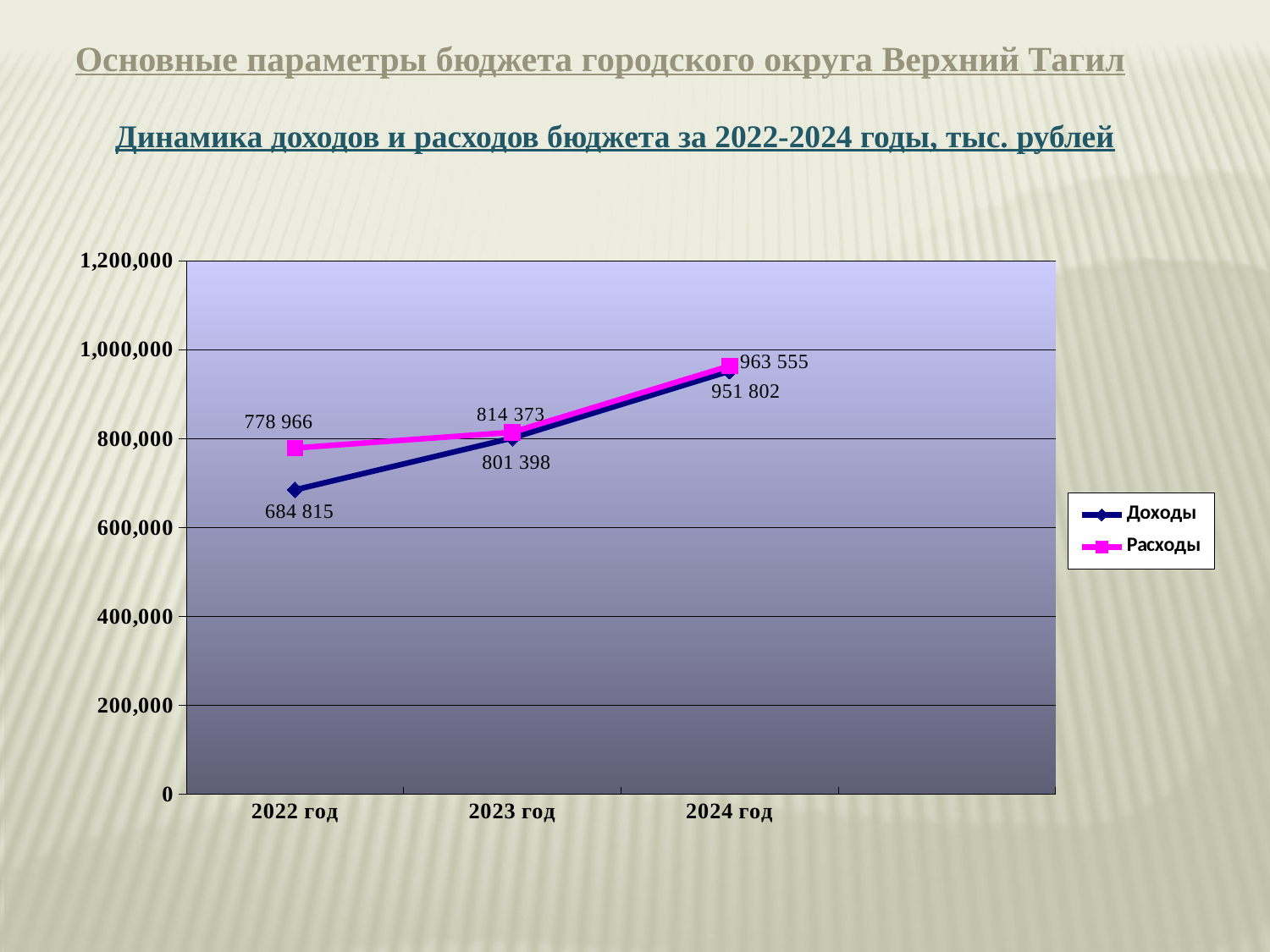
Which is larger in 2022 год, Доходы or Расходы? Расходы What is the value of Расходы for 2024 год? 963 555 What is the value of Доходы for 2024 год? 951 802 By how much did Доходы increase from 2022 год to 2024 год? 266 987 What kind of chart is shown on the slide? line chart In which year is Расходы the highest? 2024 год How many series does the legend list? 2 What is the value of Доходы for 2022 год? 684 815 What is the value of Расходы for 2023 год? 814 373 In which year is Доходы the lowest? 2022 год What is the difference between Расходы and Доходы in 2022 год? 94 151 Is the value of Доходы for 2023 год greater or less than 800,000? greater